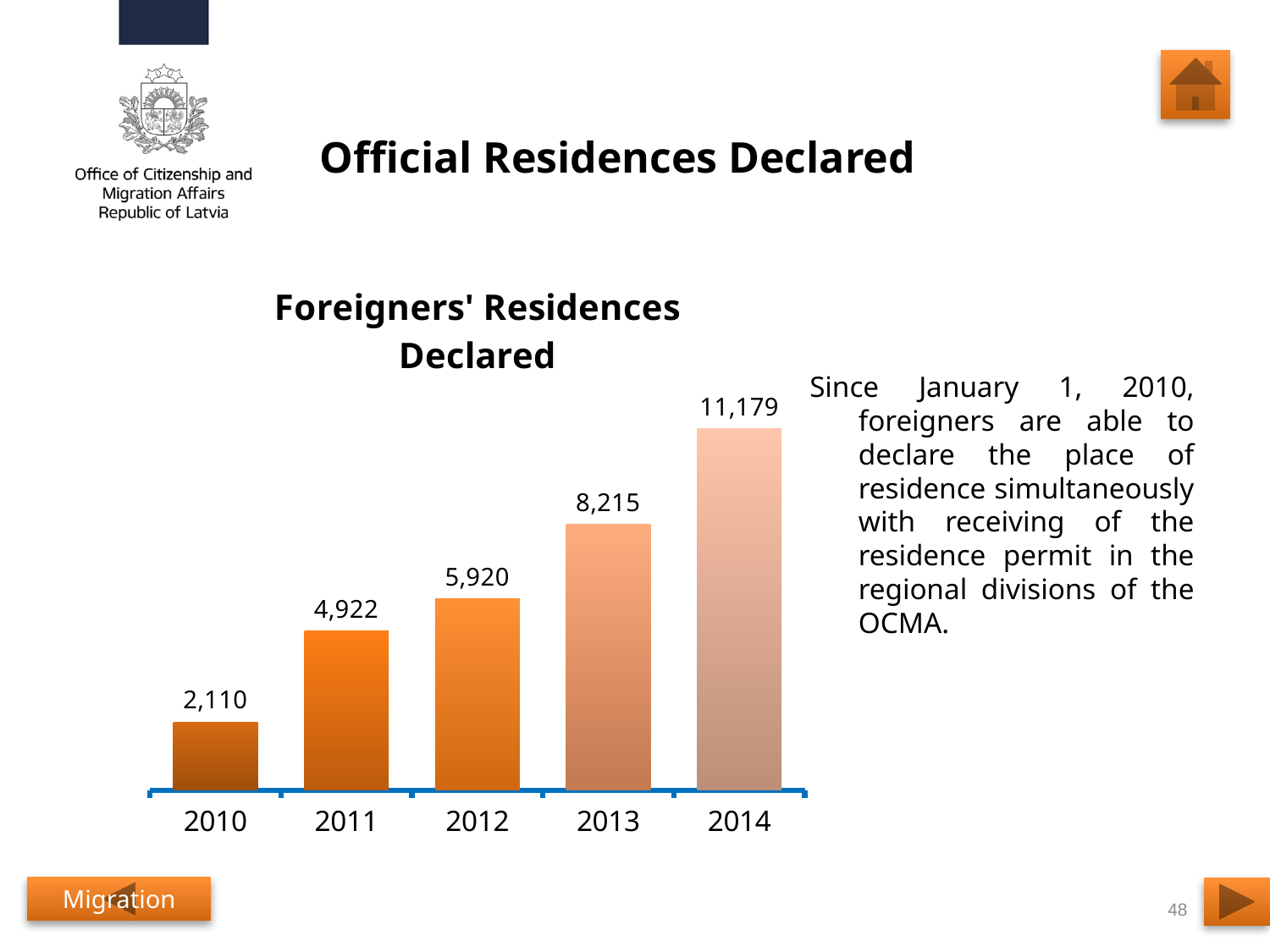
What is the difference between the values for 2011 and 2010? 2,812 What is the title of the chart? Foreigners' Residences Declared What is the value for 2014? 11,179 What kind of chart is this? bar chart What is the value for 2012? 5,920 Which year has the lowest value? 2010 How many years are shown on the x axis? 5 Which is larger, the value for 2012 or the value for 2013? 2013 What is the difference between the values for 2014 and 2013? 2,964 Do the values rise or fall from 2010 to 2014? rise Which year has the highest value? 2014 What is the value for 2010? 2,110